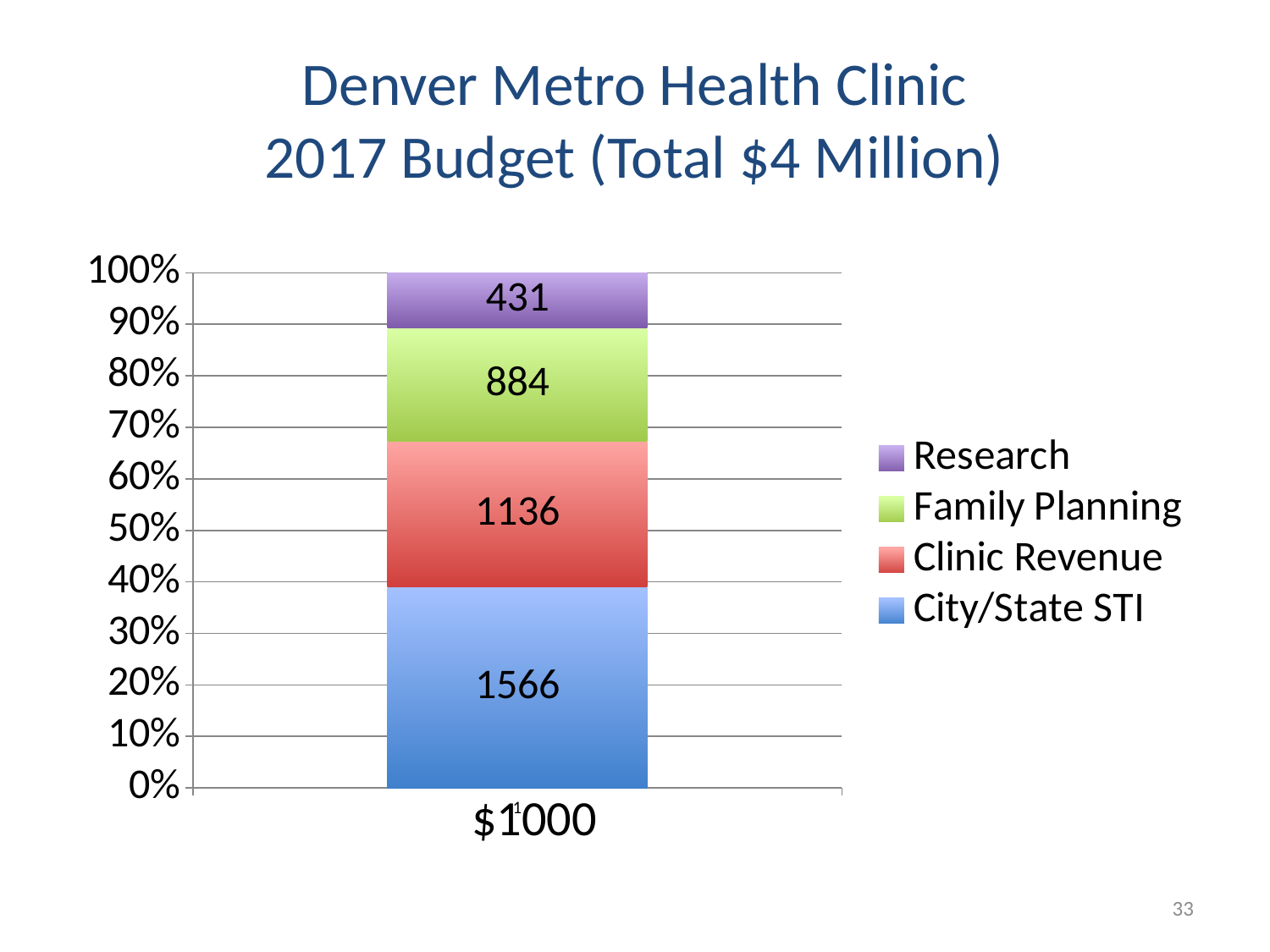
What is the title of the chart on the slide? Denver Metro Health Clinic 2017 Budget (Total $4 Million) What kind of chart is shown on the slide? Stacked bar chart Which series has the smallest value in the stacked bar? Research How many series does the legend list? 4 Which series has the largest value in the stacked bar? City/State STI Which is larger, Family Planning or Research? Family Planning What is the value for Family Planning? 884 What is the total of all segments in the stacked bar? 4017 What is the value for City/State STI? 1566 What is the difference between the City/State STI value and the Clinic Revenue value? 430 What is the value for Clinic Revenue? 1136 What is the value for Research? 431